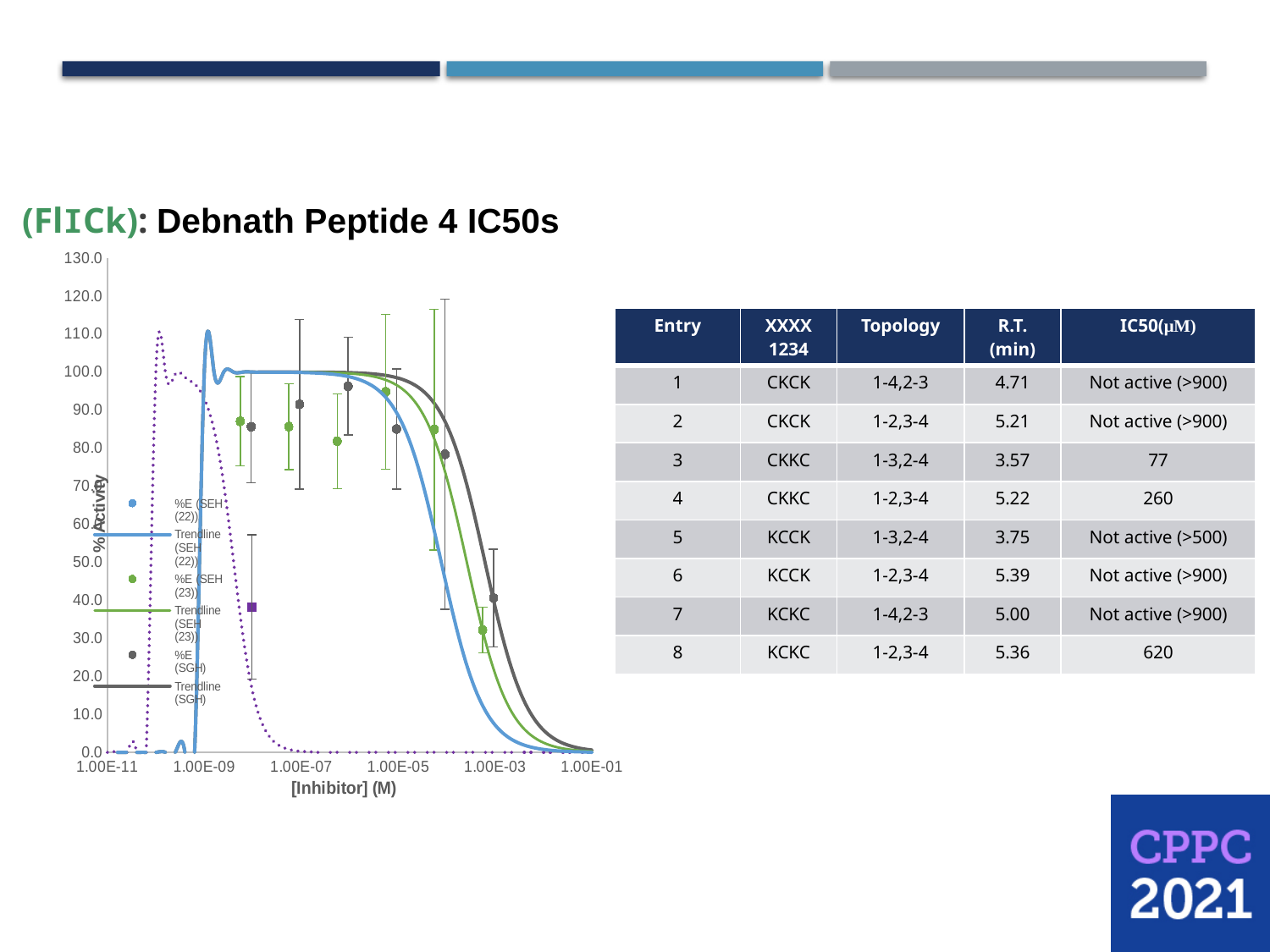
Which trendline drops to 50% activity at the lowest inhibitor concentration: Trendline (SEH (22)), Trendline (SEH (23)) or Trendline (SGH)? Trendline (SEH (22)) Is the %E (SGH) point plotted near 1.00E-06 M greater or less than 80? greater Which trendline drops to 50% activity at the highest inhibitor concentration: Trendline (SEH (22)), Trendline (SEH (23)) or Trendline (SGH)? Trendline (SGH) What is the title of the x axis of the chart? [Inhibitor] (M) What is the title of the y axis of the chart? % Activity Do the plotted % activity values rise or fall as the inhibitor concentration increases along the x axis? fall What kind of chart is shown on the slide? scatter chart How many entries does the chart legend list? 6 Is the %E (SGH) point plotted near 1.00E-03 M greater or less than 60? less Is the %E (SEH (23)) point plotted at the highest inhibitor concentration greater or less than 50? less